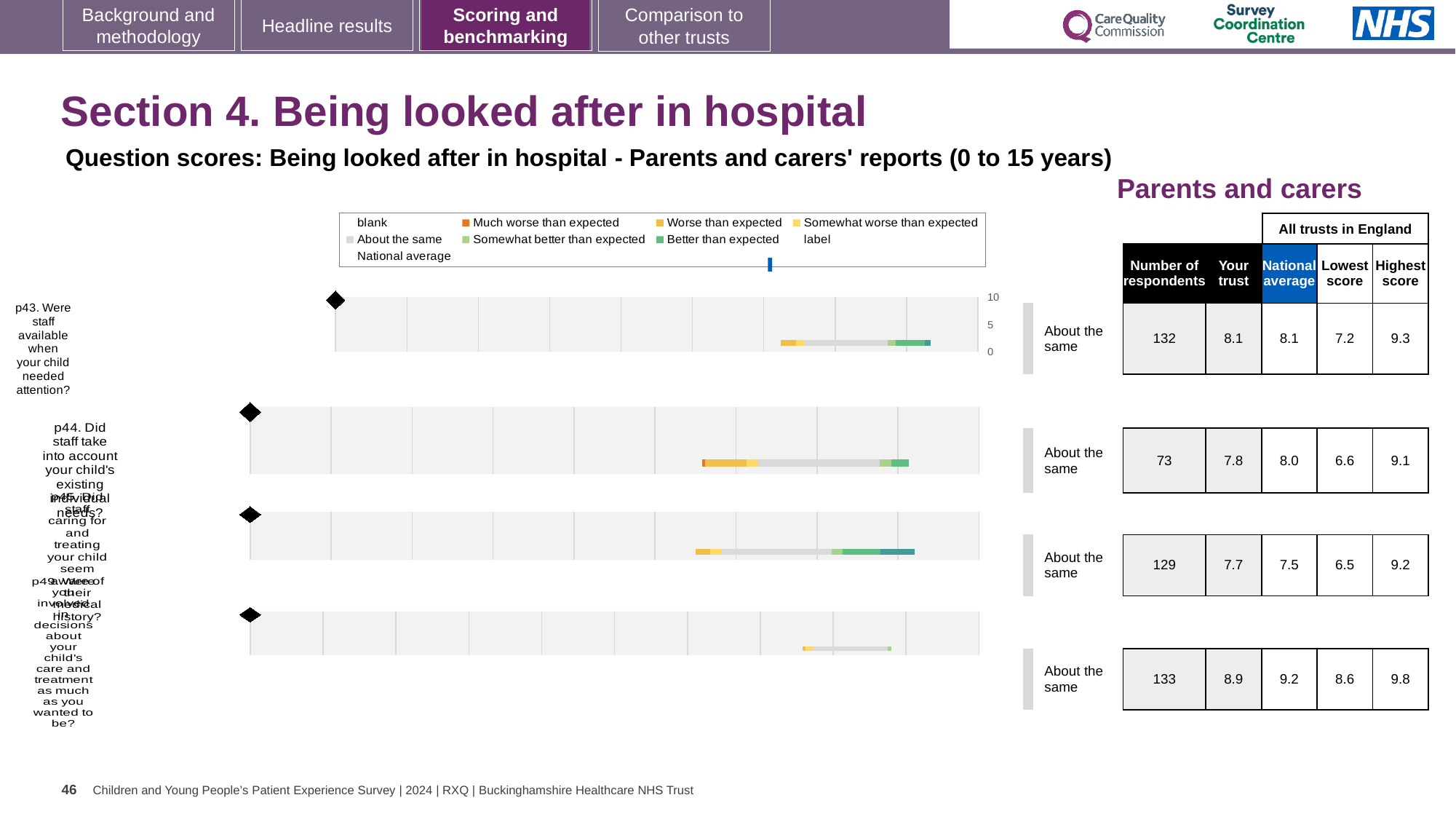
Is the 'Your trust' score for p43 greater or less than 5? greater What is the lowest score among all trusts in England for p44? 6.6 How many respondents are recorded for p44 (Did staff take into account your child's existing individual needs?)? 73 What is the highest 'Your trust' score shown in the table on this slide? 8.9 What is the lowest 'Your trust' score shown in the table on this slide? 7.7 How many question bars (charts) are shown on the slide? 4 What benchmarking category is shown next to each of the four question bars? About the same What kind of chart is used to show the question scores on this slide? bar chart For p44, which is larger: the 'Your trust' score or the national average? National average What is the national average score for p43 (Were staff available when your child needed attention?)? 8.1 What is the 'Your trust' score for p43 (Were staff available when your child needed attention?)? 8.1 What is the difference between the highest score and the lowest score for p43? 2.1